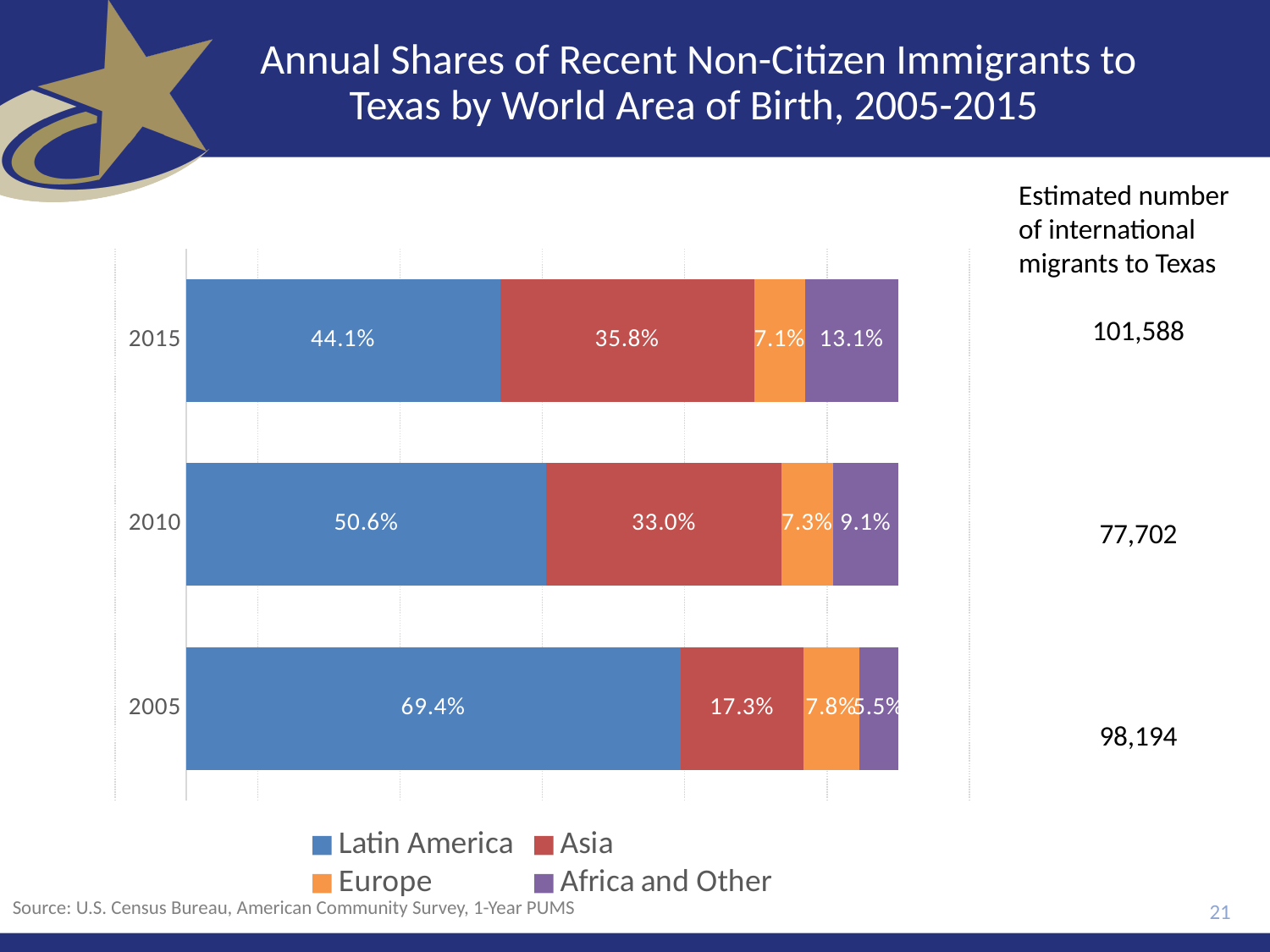
What share of recent non-citizen immigrants to Texas in 2015 were born in Latin America? 44.1% What is the Asia share for 2010? 33.0% By how many percentage points did the Latin America share fall from 2005 to 2015? 25.3 percentage points How many world areas of birth does the legend list? 4 What is the Africa and Other share for 2015? 13.1% What is the Europe share for 2005? 7.8% What is the estimated number of international migrants to Texas shown for 2015? 101,588 In which year was the Asia share the lowest? 2005 How many years are shown in the chart? 3 In which year was the Latin America share the highest? 2005 What kind of chart is shown on the slide? Stacked bar chart In 2015, which was larger: the Latin America share or the Asia share? Latin America